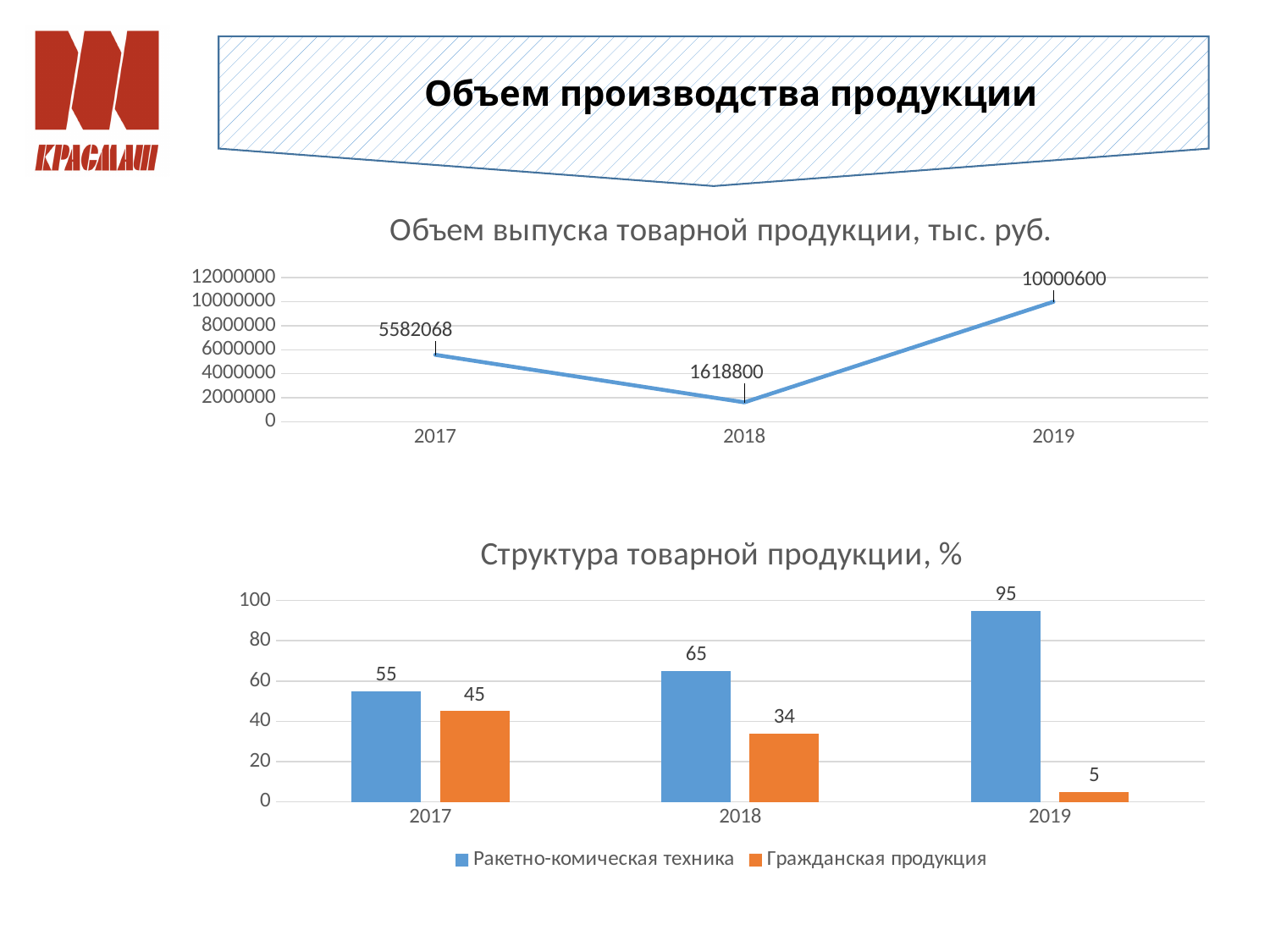
In the chart 'Структура товарной продукции, %', what is the value for Гражданская продукция in 2018? 34 In the chart 'Структура товарной продукции, %', how many series does the legend list? 2 What kind of chart is 'Структура товарной продукции, %'? bar chart In the chart 'Объем выпуска товарной продукции, тыс. руб.', how many years are plotted? 3 In the chart 'Объем выпуска товарной продукции, тыс. руб.', which year has the highest value? 2019 In the chart 'Структура товарной продукции, %', which is larger in 2017: Ракетно-комическая техника or Гражданская продукция? Ракетно-комическая техника In the chart 'Структура товарной продукции, %', what is the value for Ракетно-комическая техника in 2019? 95 What kind of chart is 'Объем выпуска товарной продукции, тыс. руб.'? line chart In the chart 'Объем выпуска товарной продукции, тыс. руб.', what is the difference between the 2019 and 2017 values? 4418532 In the chart 'Структура товарной продукции, %', does the value for Ракетно-комическая техника rise or fall from 2017 to 2019? rise In the chart 'Объем выпуска товарной продукции, тыс. руб.', which year has the lowest value? 2018 In the chart 'Объем выпуска товарной продукции, тыс. руб.', what is the value for 2018? 1618800